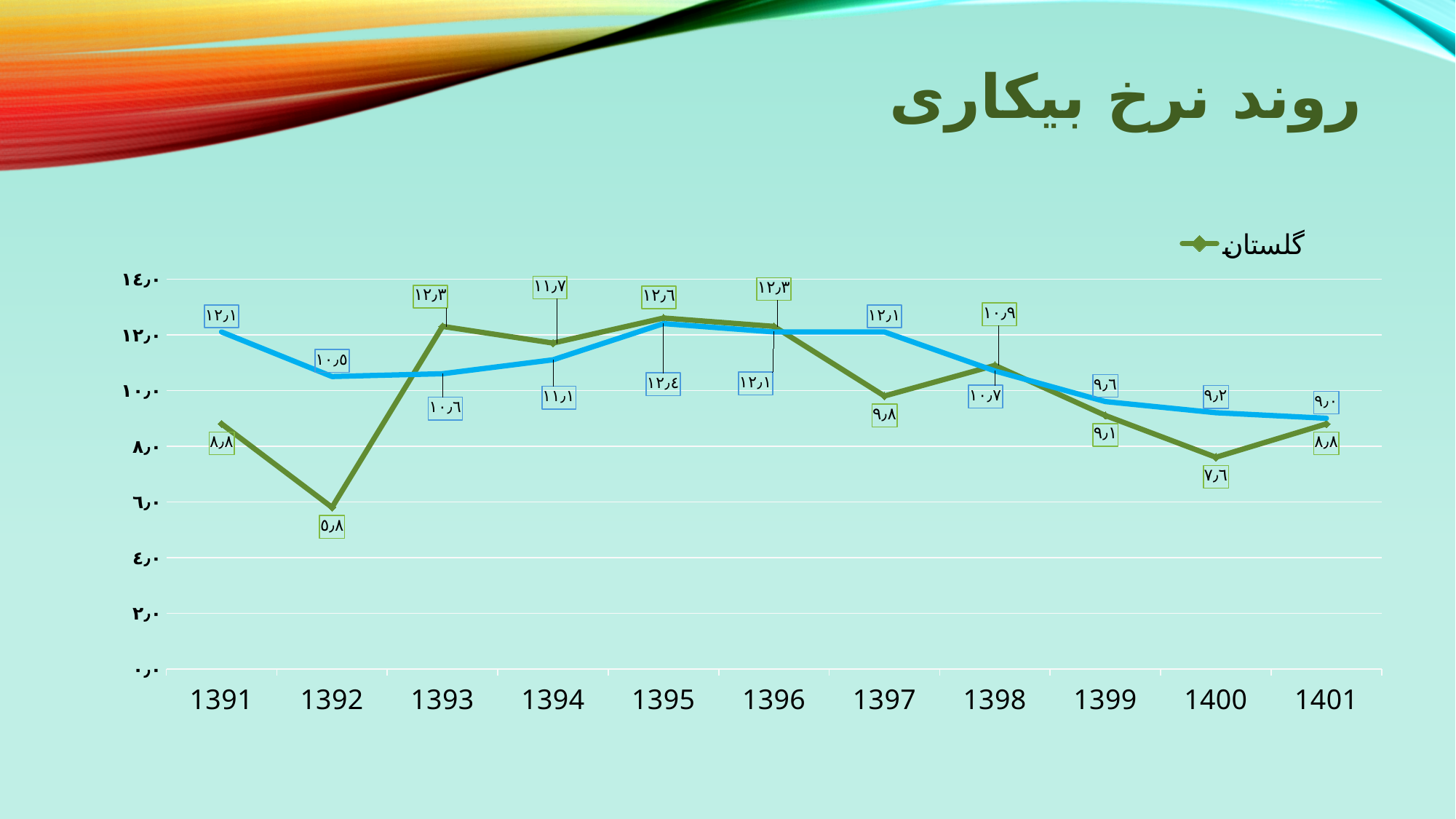
In 1391, which line has the higher value, the blue line or the گلستان (green) line? the blue line What is the name of the series shown in the legend? گلستان Does the گلستان series rise or fall from 1398 to 1400? fall How many years are plotted along the x axis? 11 In which year is the گلستان series at its lowest? 1392 In which year is the گلستان series at its highest? 1395 What is the value of the گلستان series in 1395? ۱۲٫۶ What is the value of the گلستان series in 1392? ۵٫۸ By how much did the گلستان series rise from 1392 to 1393? ۶٫۵ How many series does the legend list? 1 What kind of chart is shown on the slide? line chart What is the value of the blue line in 1401? ۹٫۰